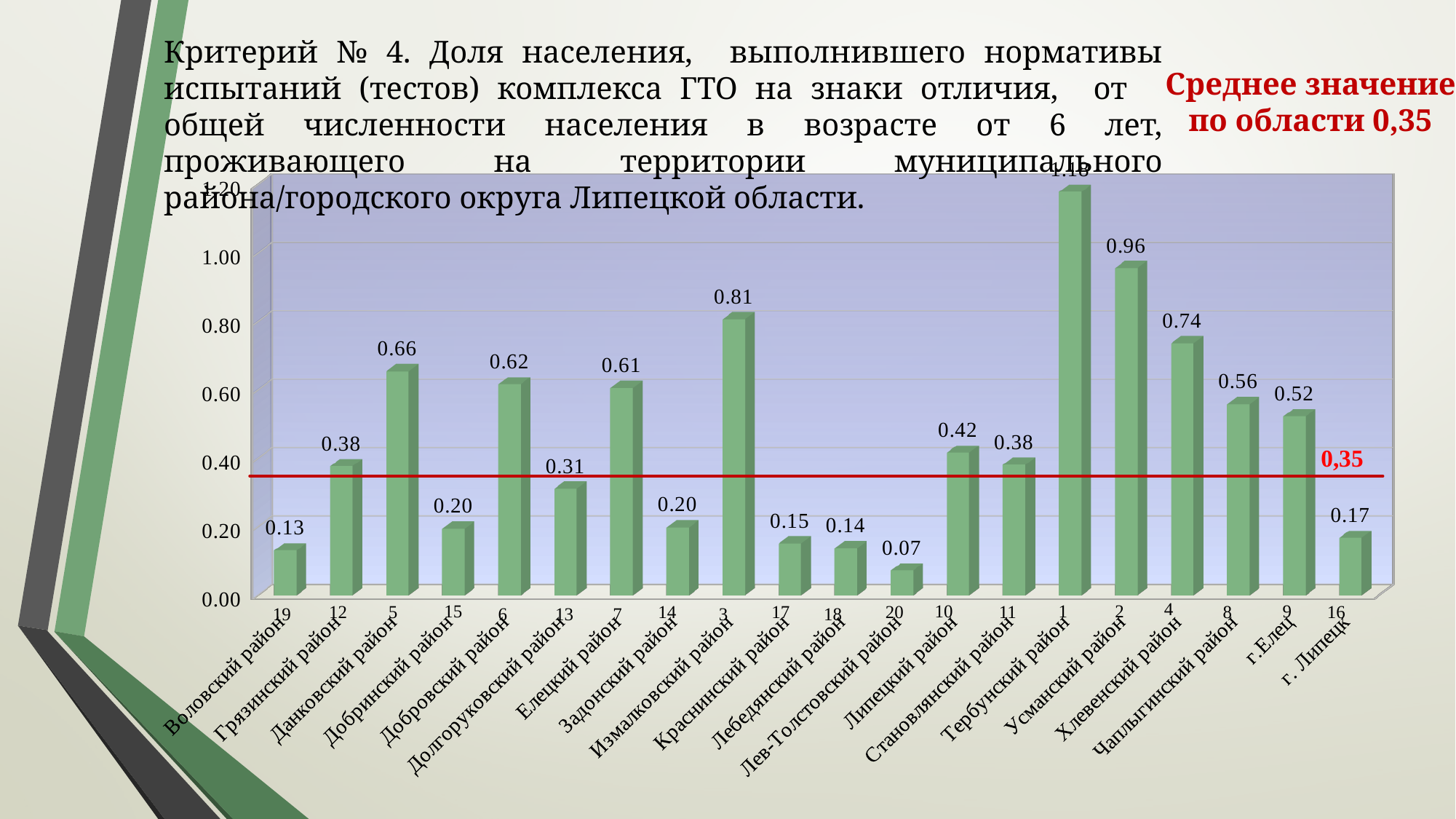
What value does the red horizontal line on the chart mark? 0,35 Which district has the highest value on the chart? Тербунский район What is the value for Долгоруковский район? 0.31 What is the value for Измалковский район? 0.81 What is the difference between the values for Данковский район and Добринский район? 0.46 What is the value for г. Липецк? 0.17 What type of chart is shown on the slide? bar chart Which district has the lowest value on the chart? Лев-Толстовский район How many districts/cities are plotted on the chart? 20 What is the value for Усманский район? 0.96 Which is larger, the value for Хлевенский район or the value for Чаплыгинский район? Хлевенский район Is the value for Липецкий район greater or less than 0.40? greater